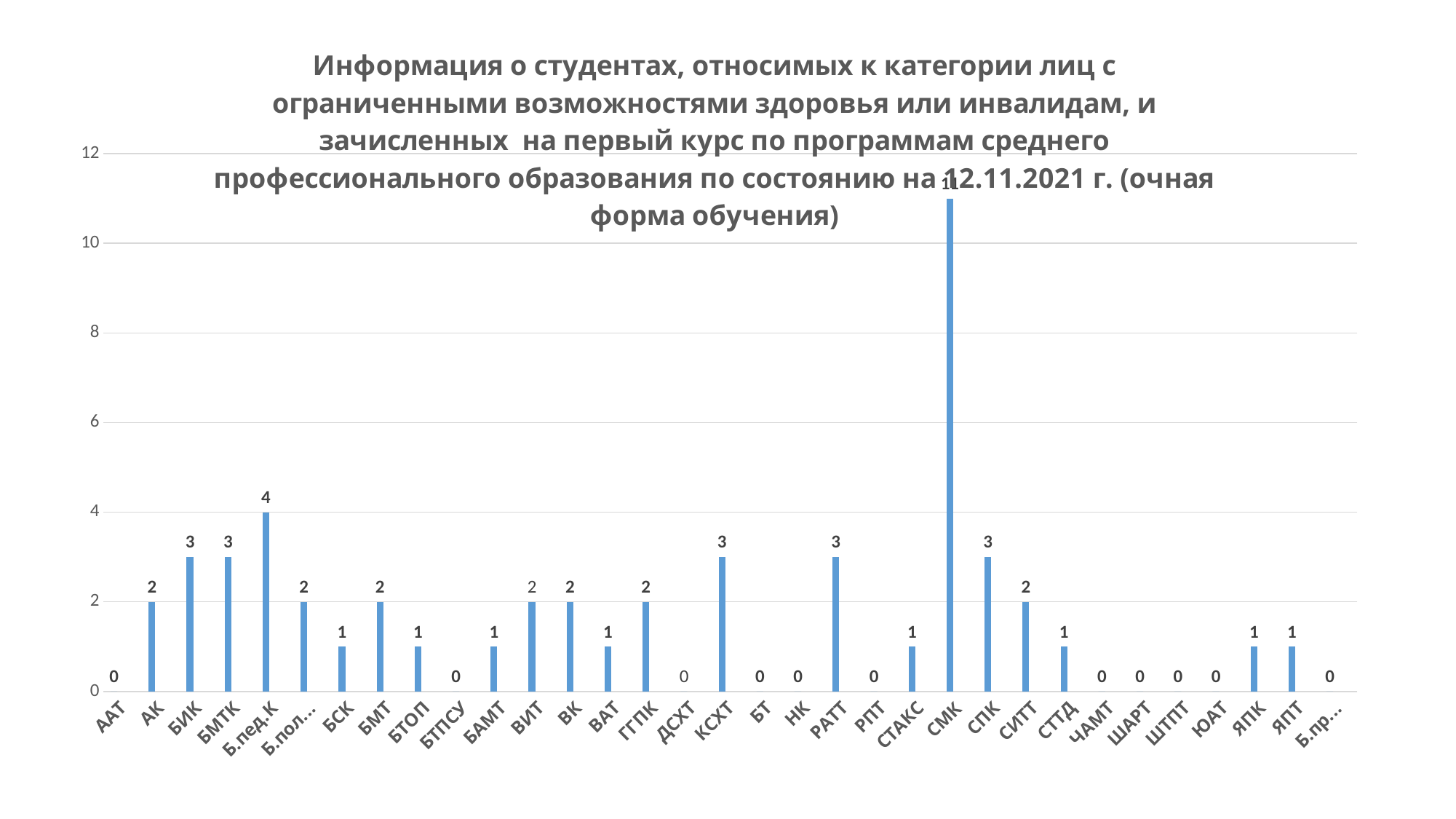
What is the difference between the values for БИК and БСК? 2 Is the value for СМК greater or less than 10? greater What is the difference between the values for СМК and Б.пед.К? 7 What date is given in the chart title? 12.11.2021 What kind of chart is shown on the slide? bar chart Which category has the highest value? СМК What is the value for Б.пед.К? 4 What is the value for СМК? 11 What is the value for ААТ? 0 Which is larger, the value for КСХТ or the value for СТТД? КСХТ How many categories are shown on the x axis? 33 What is the value for РАТТ? 3